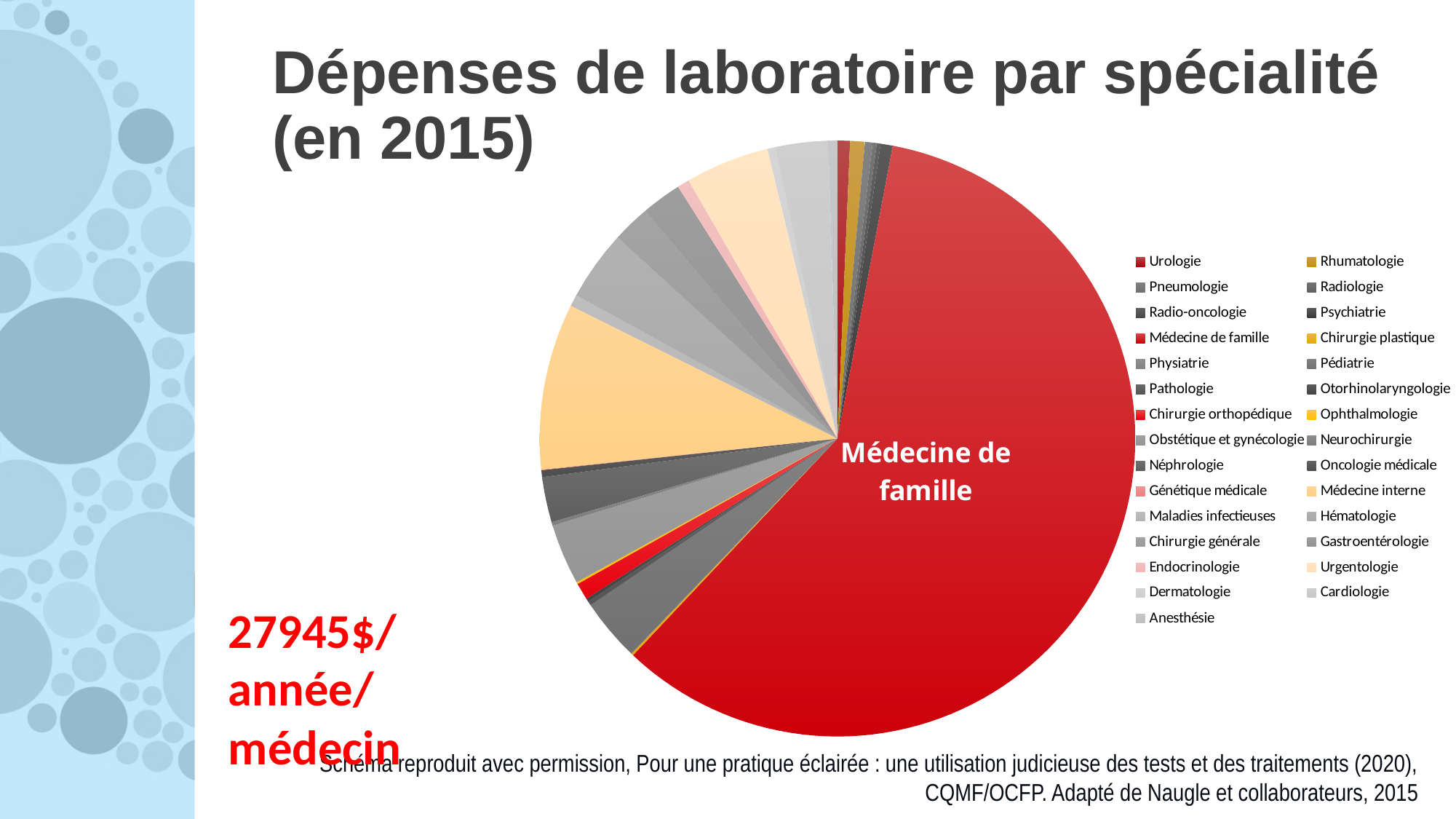
What is the title of the chart on the slide? Dépenses de laboratoire par spécialité (en 2015) Which specialty has the largest share of laboratory expenses in the pie chart? Médecine de famille How many specialties are listed in the legend of the pie chart? 29 Which slice is larger, Médecine de famille or Médecine interne? Médecine de famille Which slice is larger, Médecine interne or Urgentologie? Médecine interne Which slice of the pie chart carries a text label directly on it? Médecine de famille What kind of chart is shown on the slide? Pie chart Is the Médecine de famille slice larger or smaller than all the other slices combined? Larger